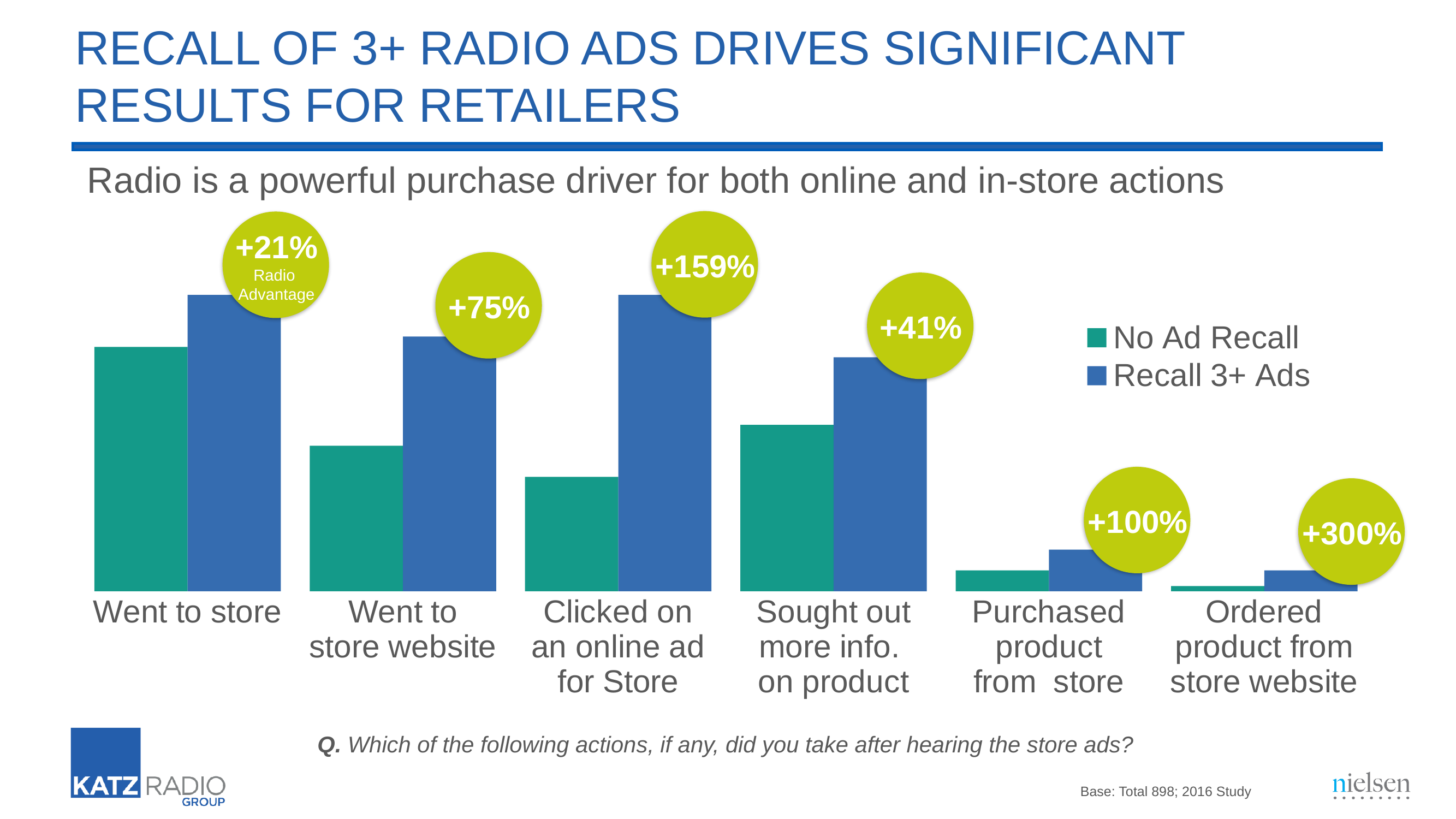
What are the two series named in the legend? No Ad Recall and Recall 3+ Ads What is the Radio Advantage shown for "Went to store"? +21% For "Purchased product from store", which series has the larger value, No Ad Recall or Recall 3+ Ads? Recall 3+ Ads What is the Radio Advantage shown for "Ordered product from store website"? +300% How many series does the legend list? 2 Which category has the largest Radio Advantage percentage? Ordered product from store website How many action categories are shown along the x axis? 6 What kind of chart is shown on the slide? bar chart Which category has the smallest Radio Advantage percentage? Went to store What is the Radio Advantage shown for "Clicked on an online ad for Store"? +159% What is the Radio Advantage shown for "Sought out more info. on product"? +41%